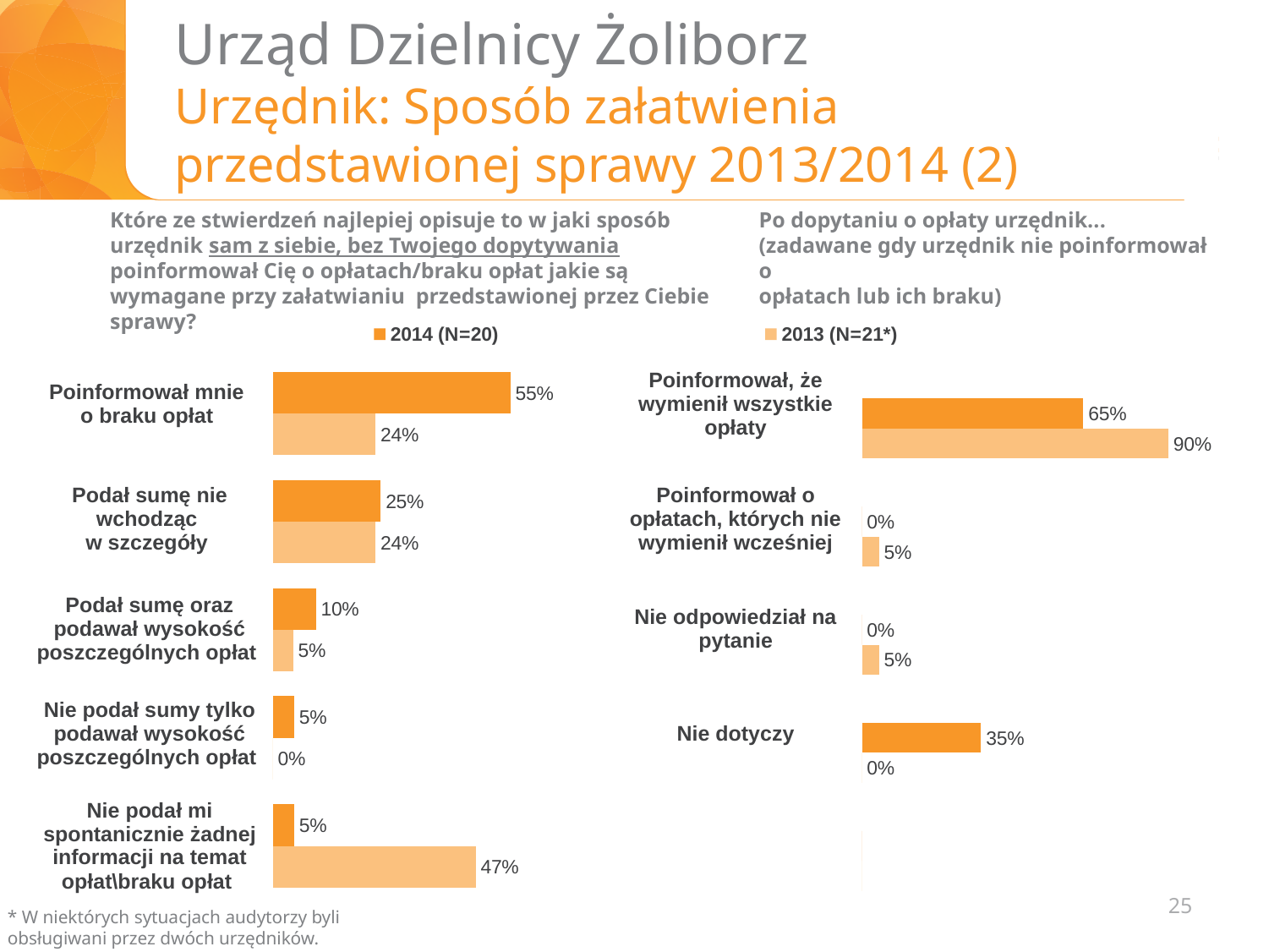
In the left chart, which is larger for "Nie podał mi spontanicznie żadnej informacji na temat opłat\braku opłat": the 2014 value or the 2013 value? 2013 In the left chart, what is the 2014 value for "Poinformował mnie o braku opłat"? 55% In the right chart, what is the difference between the 2013 and 2014 values for "Poinformował, że wymienił wszystkie opłaty"? 25 percentage points How many categories does the left chart show? 5 What type of chart is used on this slide? Bar chart In the right chart, what is the 2013 value for "Poinformował, że wymienił wszystkie opłaty"? 90% In the right chart, what is the 2014 value for "Nie dotyczy"? 35% In the left chart, what is the difference between the 2014 and 2013 values for "Poinformował mnie o braku opłat"? 31 percentage points How many categories does the right chart show? 4 In the left chart, which category has the lowest 2013 value? Nie podał sumy tylko podawał wysokość poszczególnych opłat In the left chart, what is the 2013 value for "Nie podał mi spontanicznie żadnej informacji na temat opłat\braku opłat"? 47% In the left chart, which category has the highest 2014 value? Poinformował mnie o braku opłat